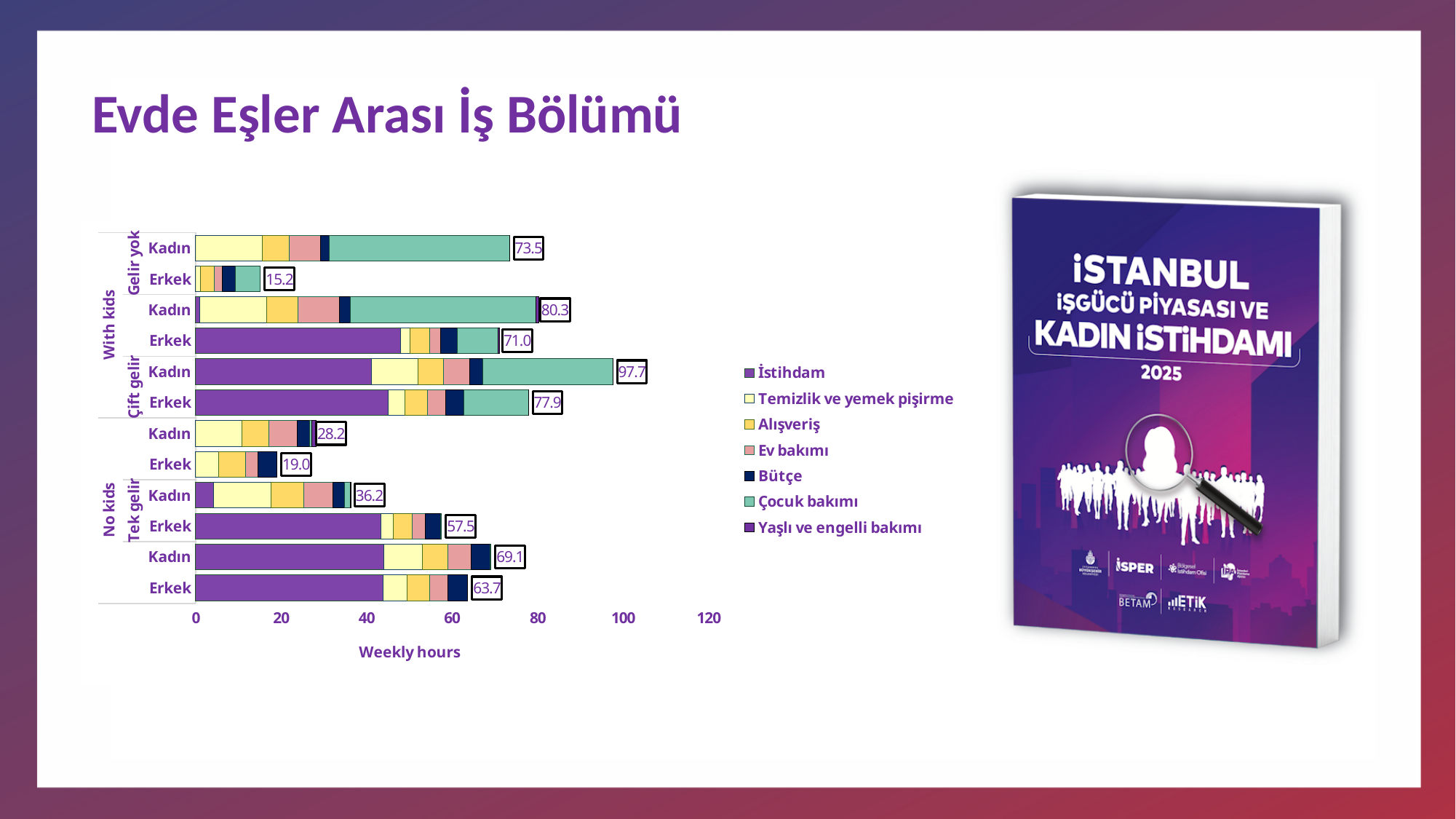
How many bars are plotted in the chart? 12 What is the total weekly hours shown for the bottom-most bar (Erkek) in the chart? 63.7 Which bar has the lowest total weekly hours? Erkek, Gelir yok, With kids (15.2) How many series does the chart legend list? 7 Which bar has the highest total weekly hours? Kadın, Çift gelir, With kids (97.7) In the 'Tek gelir' group under 'No kids', which has the larger total weekly hours, Kadın or Erkek? Erkek What is the total weekly hours for Erkek in the 'Gelir yok' group under 'With kids'? 15.2 In the 'Çift gelir' group under 'With kids', what is the difference between the Kadın total (97.7) and the Erkek total (77.9)? 19.8 What is the total weekly hours for Kadın in the 'Çift gelir' group under 'With kids'? 97.7 What is the title of the horizontal axis of the chart? Weekly hours What kind of chart is shown on the slide? Stacked bar chart What is the total weekly hours for Kadın in the 'Gelir yok' group under 'With kids'? 73.5